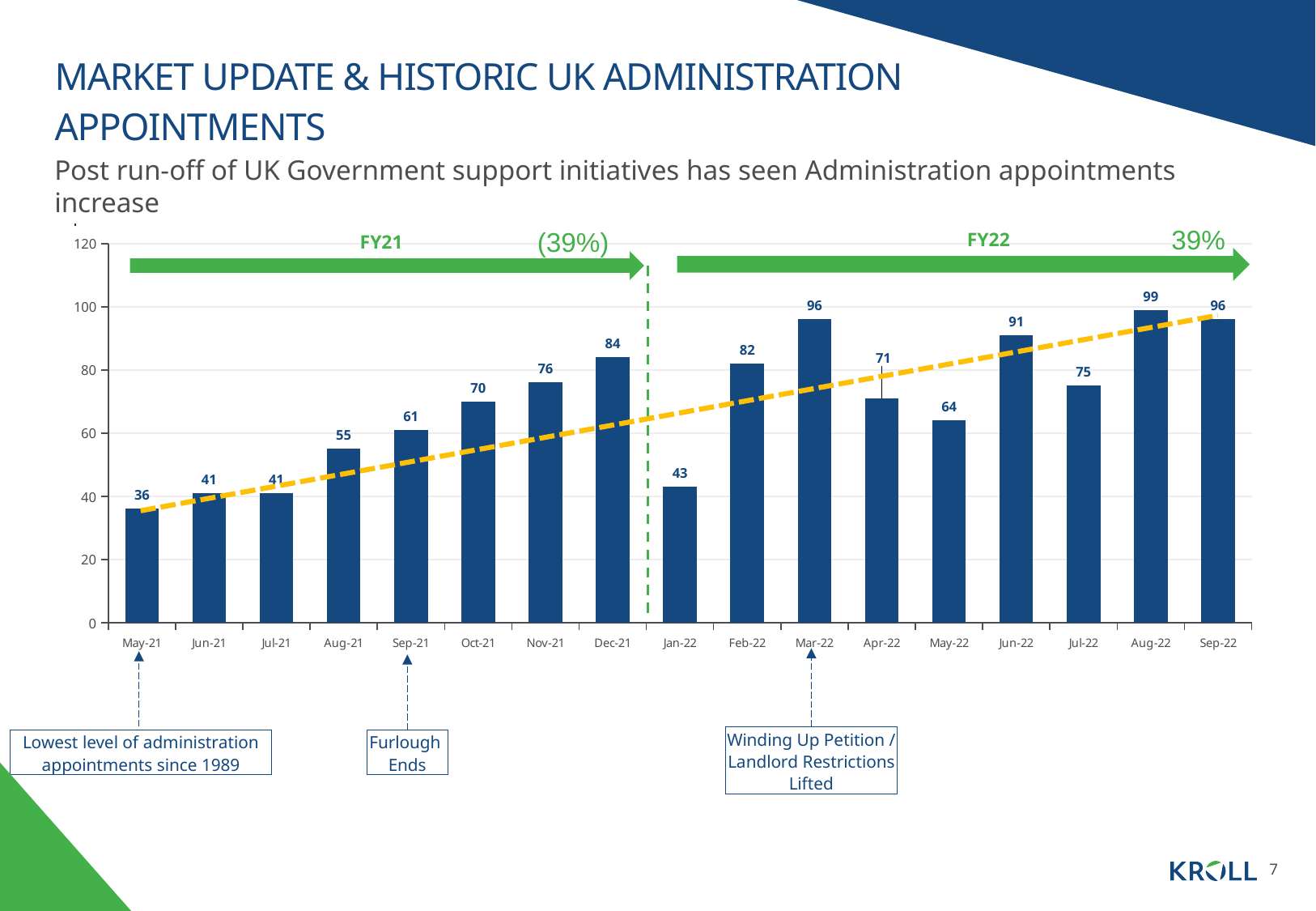
What is the value for Dec-21? 84 How many months are plotted on the chart? 17 What kind of chart is shown on the slide? Bar chart Which month has the highest value? Aug-22 What is the difference between the values for Aug-22 and May-21? 63 Which month has the lowest value? May-21 Do the values generally rise or fall from May-21 to Dec-21? Rise What is the value for Jan-22? 43 What is the value for Mar-22? 96 Which is larger, the value for Feb-22 or the value for Apr-22? Feb-22 What annotation is attached to the Sep-21 bar? Furlough Ends What is the difference between the values for Jun-22 and Jul-22? 16